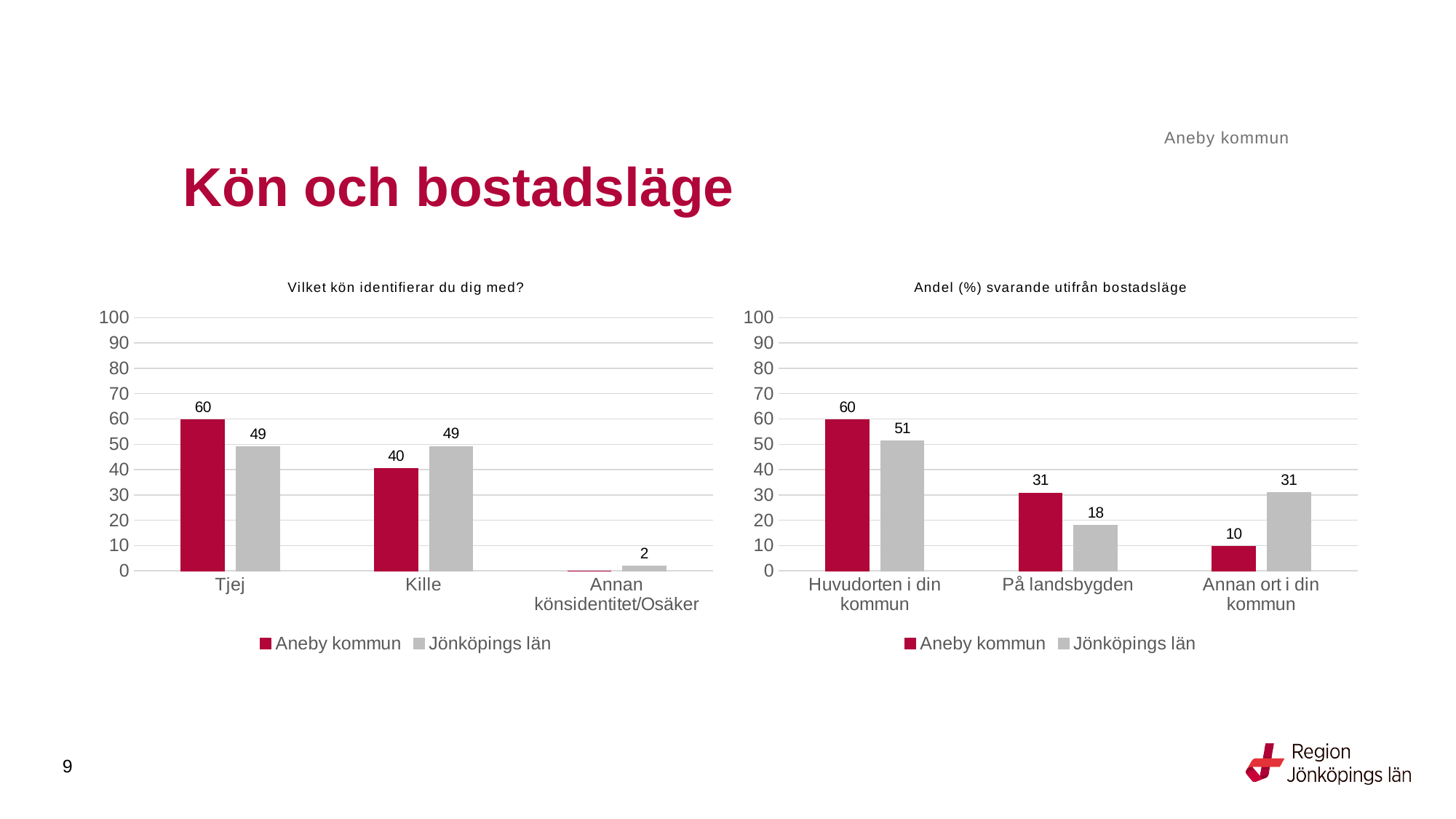
In the chart titled "Vilket kön identifierar du dig med?", what is the difference between the Aneby kommun values for Tjej and Kille? 20 In the chart titled "Andel (%) svarande utifrån bostadsläge", what is the difference between Aneby kommun and Jönköpings län for På landsbygden? 13 In the chart titled "Andel (%) svarande utifrån bostadsläge", what is the value for Aneby kommun for På landsbygden? 31 In the chart titled "Andel (%) svarande utifrån bostadsläge", which category has the lowest Aneby kommun value? Annan ort i din kommun In the chart titled "Vilket kön identifierar du dig med?", what is the value for Jönköpings län for Kille? 49 In the chart titled "Andel (%) svarande utifrån bostadsläge", what is the value for Jönköpings län for Huvudorten i din kommun? 51 In the chart titled "Vilket kön identifierar du dig med?", what is the value for Aneby kommun for Tjej? 60 In the chart titled "Vilket kön identifierar du dig med?", which category has the highest Aneby kommun value? Tjej What kind of chart is the chart titled "Vilket kön identifierar du dig med?"? Bar chart In the chart titled "Vilket kön identifierar du dig med?", what is the value for Jönköpings län for Annan könsidentitet/Osäker? 2 How many series does the legend of the chart titled "Andel (%) svarande utifrån bostadsläge" list? 2 In the chart titled "Andel (%) svarande utifrån bostadsläge", which is larger for Annan ort i din kommun: Aneby kommun or Jönköpings län? Jönköpings län